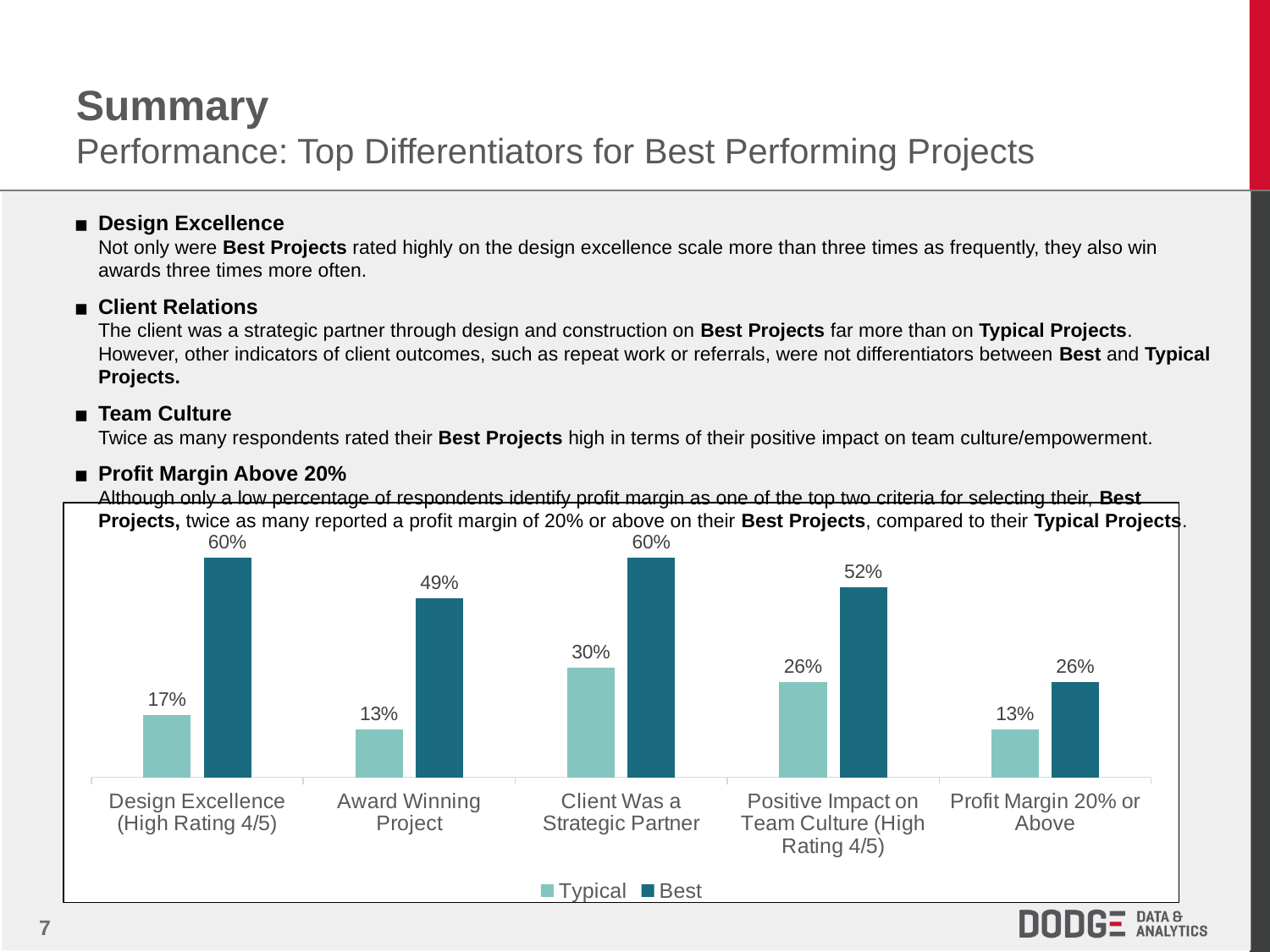
What is the value for Typical on Client Was a Strategic Partner? 30% What is the difference between Best and Typical on Profit Margin 20% or Above? 13% What is the value for Typical on Award Winning Project? 13% What is the difference between Best and Typical on Award Winning Project? 36% What is the value for Best on Design Excellence (High Rating 4/5)? 60% Which category has the lowest Best value? Profit Margin 20% or Above What kind of chart is shown on the slide? Bar chart Which category has the highest Typical value? Client Was a Strategic Partner Which is larger: the Typical value for Design Excellence (High Rating 4/5) or the Typical value for Positive Impact on Team Culture (High Rating 4/5)? Positive Impact on Team Culture (High Rating 4/5) How many categories are shown on the x axis? 5 What is the value for Best on Positive Impact on Team Culture (High Rating 4/5)? 52% How many series does the legend list? 2